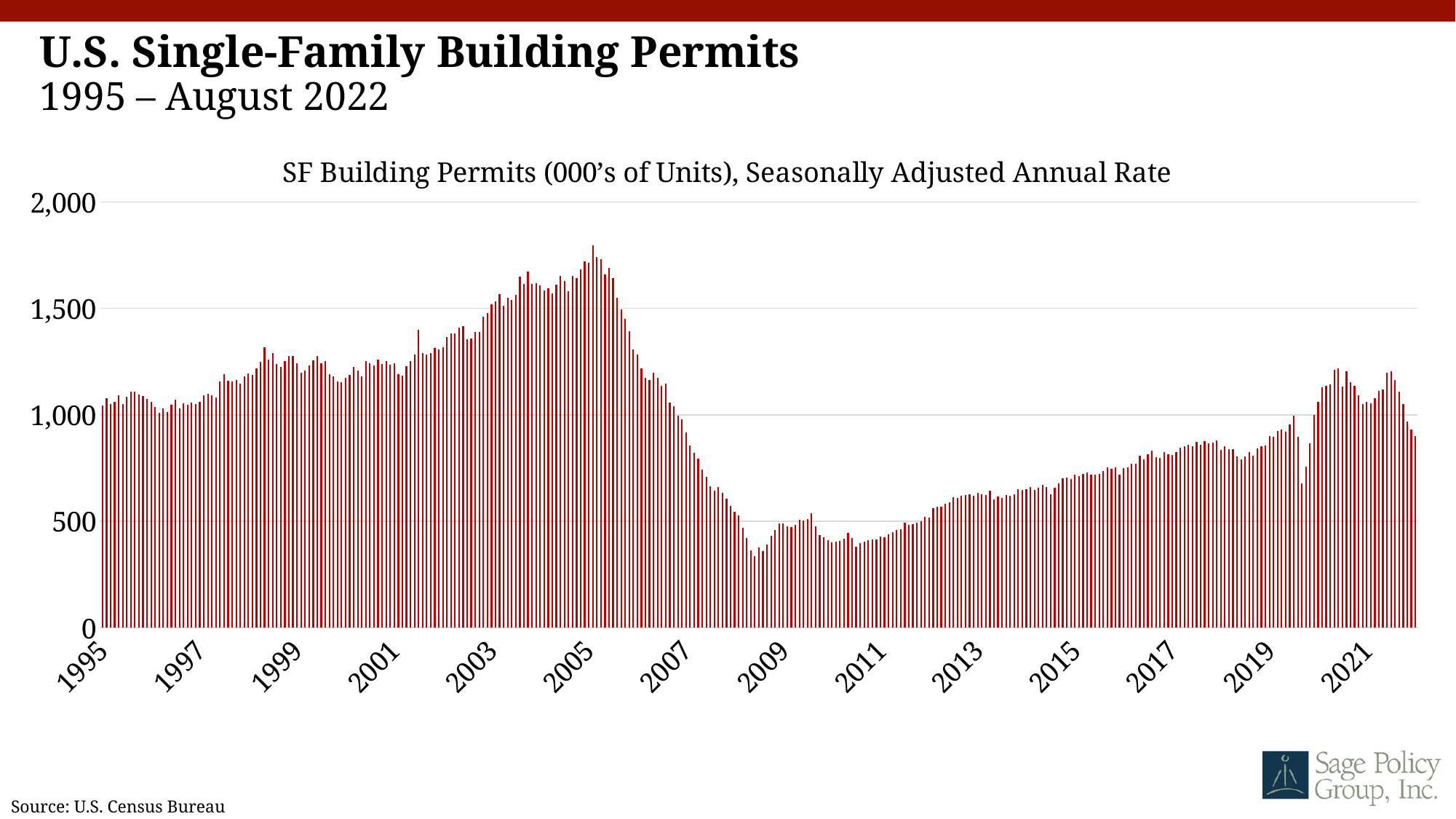
Is the value at the 2017 tick greater or less than 1,000? less Is the highest value on the chart greater or less than 1,500? greater Is the lowest value on the chart greater or less than 500? less What is the title of the chart? SF Building Permits (000's of Units), Seasonally Adjusted Annual Rate What kind of chart is shown on the slide? bar chart Do the values rise or fall between 2006 and 2009? fall What source is cited for the chart data? U.S. Census Bureau Which is larger, the value at the 2005 tick or the value at the 2009 tick? 2005 Do the values rise or fall between 2011 and 2019? rise